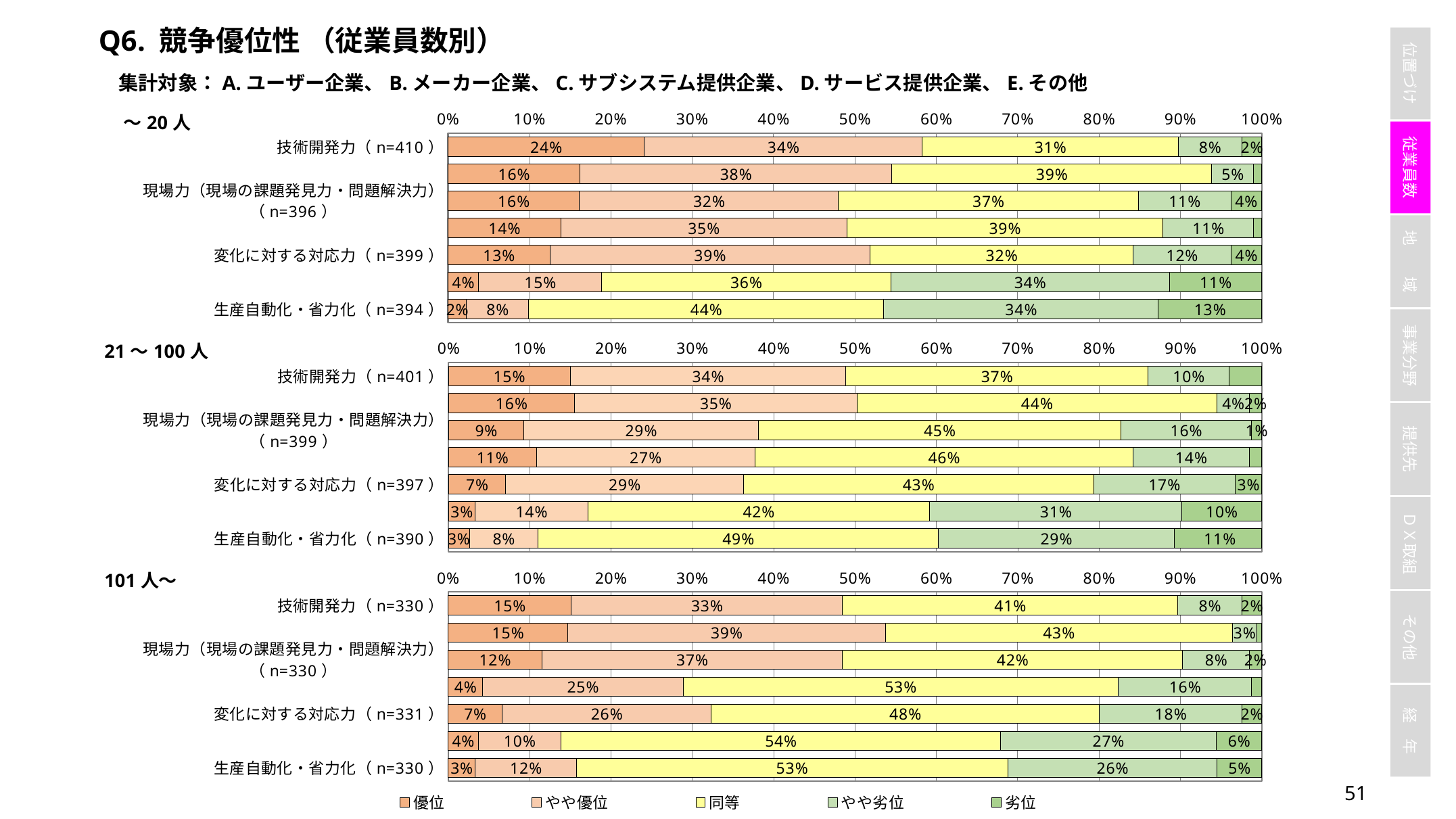
In the ～20人 chart, which response category is the smallest segment of the 技術開発力 (n=410) bar? 劣位 How many bars does the ～20人 chart contain? 7 In the ～20人 chart, what is the 優位 value for 技術開発力 (n=410)? 24% In the ～20人 chart, what is the 同等 value for 生産自動化・省力化 (n=394)? 44% What is the first entry in the legend? 優位 How many series does the legend list? 5 In the 101人～ chart, what is the difference between the 同等 value for 生産自動化・省力化 (53%) and the 同等 value for 技術開発力 (41%)? 12 percentage points In the 101人～ chart, which response category is the largest segment of the 技術開発力 (n=330) bar? 同等 In the 21～100人 chart, what is the 同等 value for 変化に対する対応力 (n=397)? 43% In the ～20人 chart, which has the larger 優位 share: 技術開発力 or 生産自動化・省力化? 技術開発力 What kind of chart is used for the 21～100人 section? Stacked bar chart In the 101人～ chart, what is the やや劣位 value for 生産自動化・省力化 (n=330)? 26%